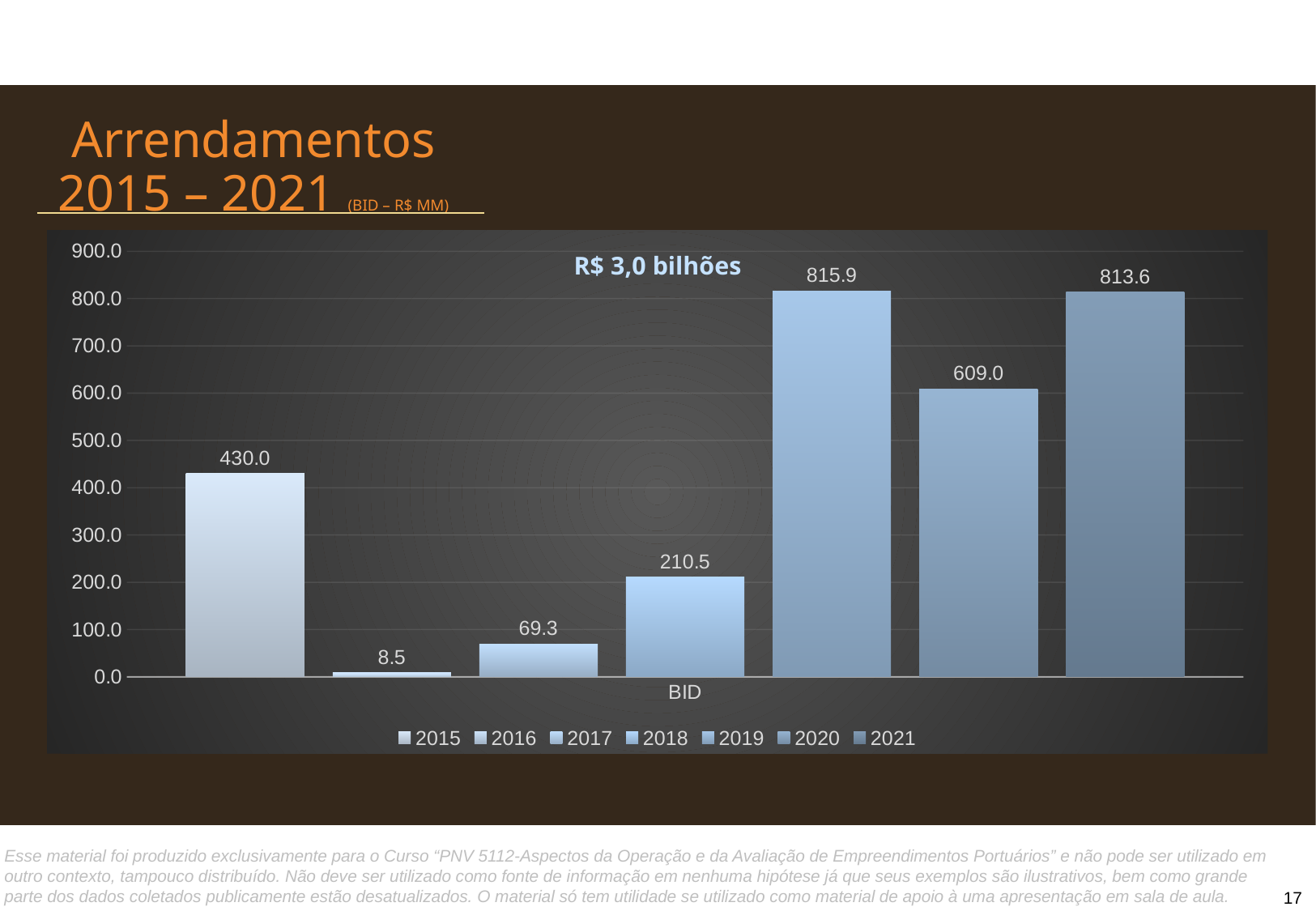
What is the difference between the values for 2020 and 2017? 539.7 What is the value for 2015? 430.0 What total amount is annotated in the chart area? R$ 3,0 bilhões Which is larger, the value for 2018 or the value for 2020? 2020 Which year has the highest value? 2019 What is the value for 2019? 815.9 Which year has the lowest value? 2016 What is the difference between the values for 2015 and 2018? 219.5 What is the value for 2020? 609.0 What type of chart is shown on the slide? bar chart How many series does the legend list? 7 What is the value for 2017? 69.3